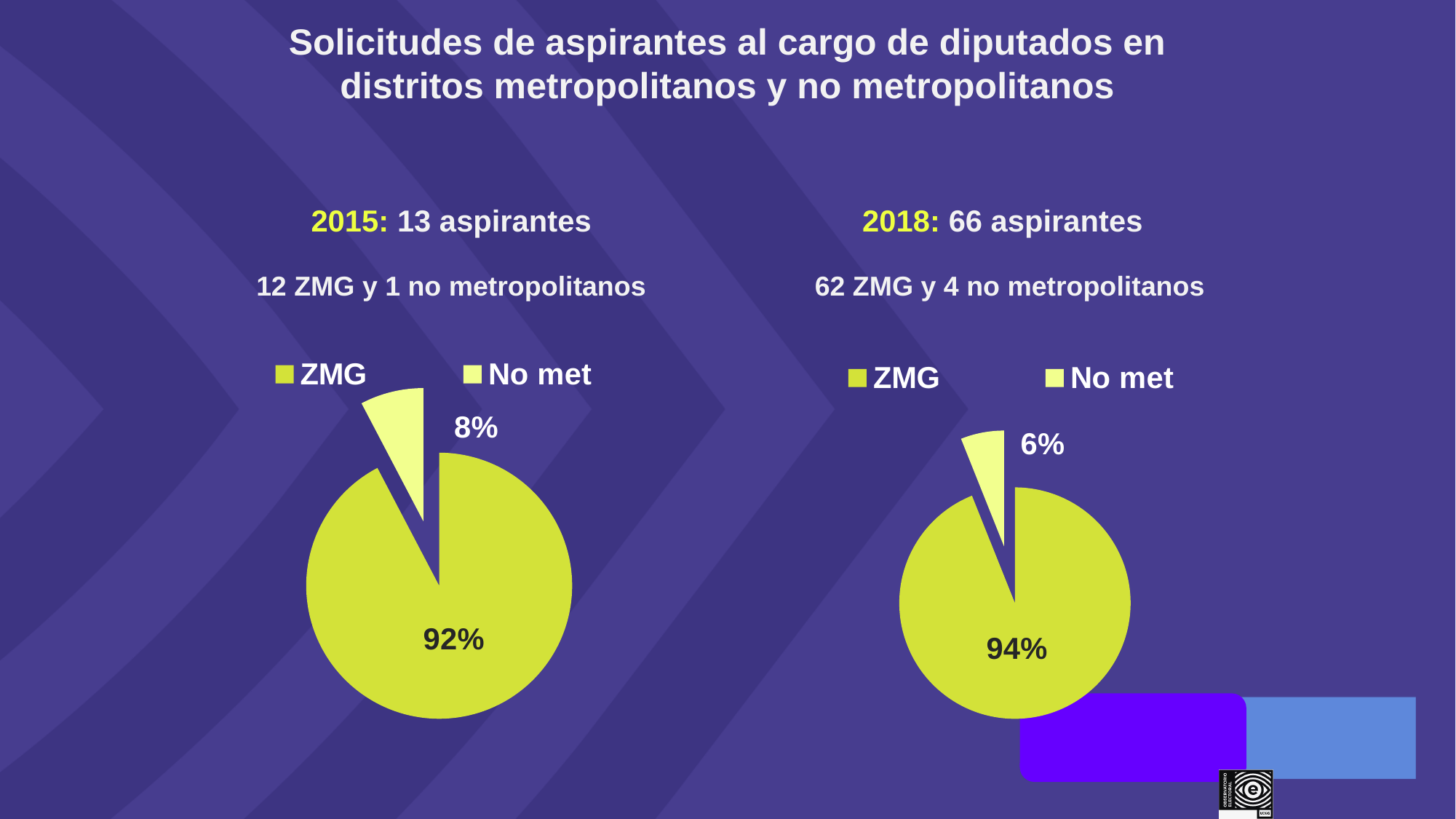
In the 2018 pie chart, what share does ZMG have? 94% In the 2018 pie chart, which category has the smallest slice? No met Is the No met share larger in the 2015 pie chart or the 2018 pie chart? 2015 In the 2015 pie chart, what is the difference in percentage points between ZMG and No met? 84 How many entries does the legend of the 2015 pie chart list? 2 In the 2015 pie chart, what share does No met have? 8% In the 2015 pie chart, which category has the largest slice? ZMG What kind of chart is used for the 2015 data? Pie chart What are the two legend entries of the 2018 pie chart? ZMG and No met In the 2015 pie chart, what share does ZMG have? 92% In the 2018 pie chart, what share does No met have? 6% How many slices does the 2018 pie chart have? 2